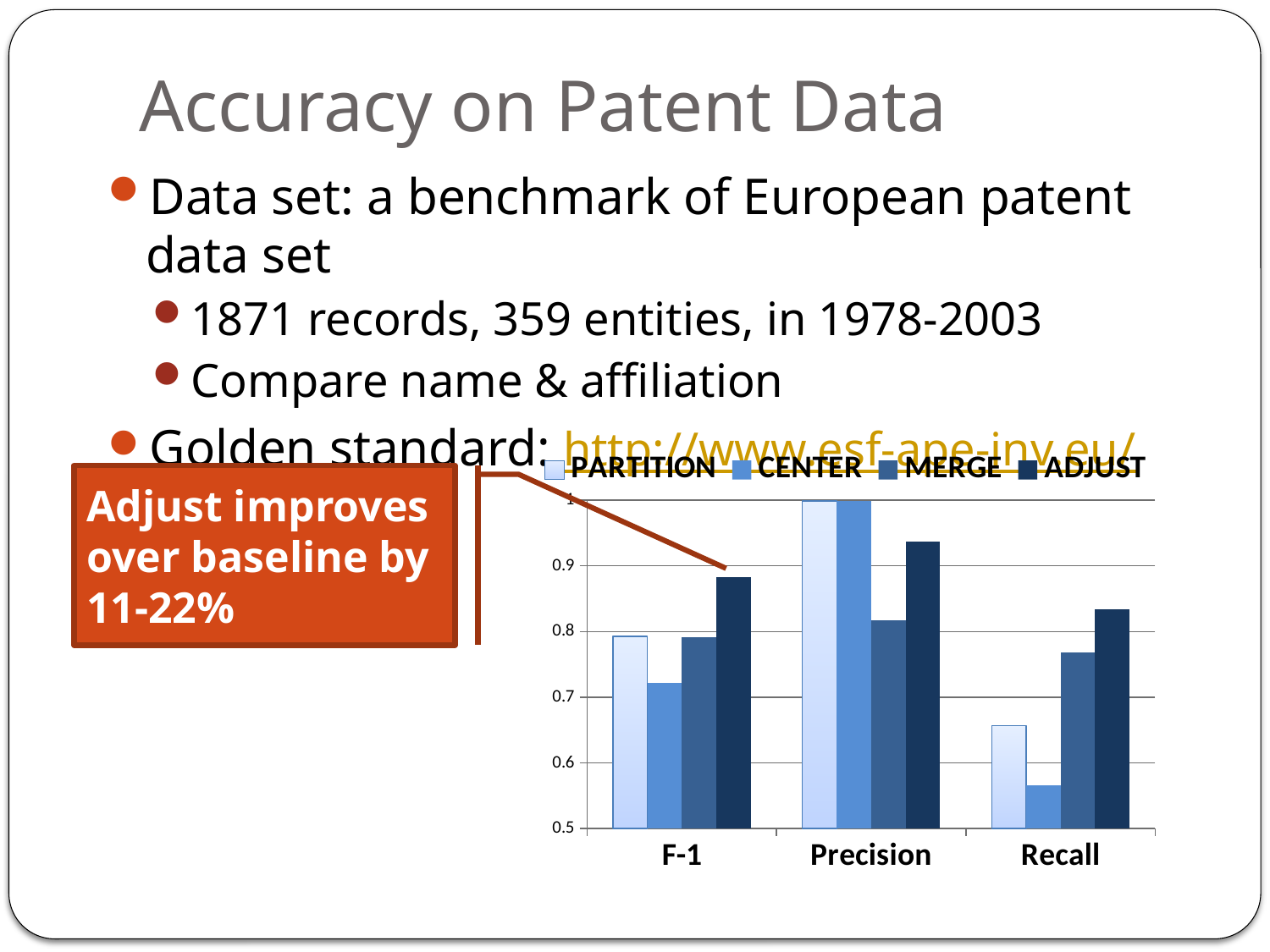
Which series has the lowest value for F-1? CENTER Which series has the lowest value for Precision? MERGE What kind of chart is shown on the slide? bar chart How many categories are shown on the x axis of the chart? 3 Which series has the lowest value for Recall? CENTER Which series has the highest value for Recall? ADJUST Which series is shown in the darkest blue in the chart legend? ADJUST Is the MERGE value for Precision greater or less than 0.9? less For Recall, which is larger: the MERGE value or the PARTITION value? MERGE Is the ADJUST value for F-1 greater or less than 0.8? greater How many series does the chart legend list? 4 Is the CENTER value for Recall greater or less than 0.6? less